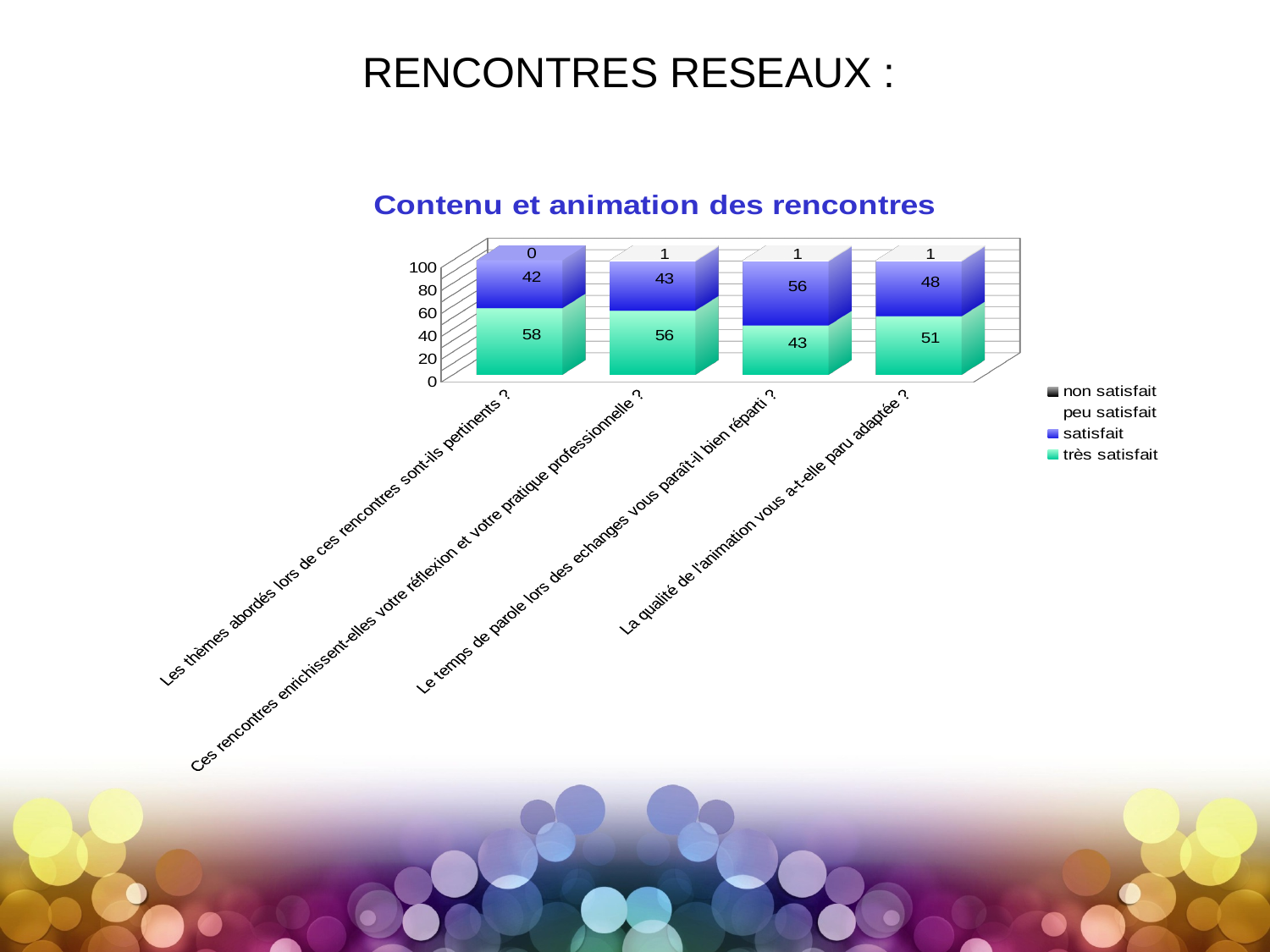
What is the 'satisfait' value for 'Le temps de parole lors des echanges vous paraît-il bien réparti ?'? 56 How many series does the chart legend list? 4 What kind of chart is shown on the slide? Stacked bar chart Which has the larger 'satisfait' value: 'Le temps de parole lors des echanges vous paraît-il bien réparti ?' or 'La qualité de l'animation vous a-t-elle paru adaptée ?'? Le temps de parole lors des echanges vous paraît-il bien réparti ? What is the 'très satisfait' value for 'La qualité de l'animation vous a-t-elle paru adaptée ?'? 51 What is the 'très satisfait' value for 'Les thèmes abordés lors de ces rencontres sont-ils pertinents ?'? 58 What is the 'satisfait' value for 'Ces rencontres enrichissent-elles votre réflexion et votre pratique professionnelle ?'? 43 How many questions (categories) are shown on the x axis of the chart? 4 For 'Les thèmes abordés lors de ces rencontres sont-ils pertinents ?', how much larger is the 'très satisfait' value than the 'satisfait' value? 16 Which question has the lowest 'très satisfait' value? Le temps de parole lors des echanges vous paraît-il bien réparti ? What is the difference between the 'satisfait' values for 'La qualité de l'animation vous a-t-elle paru adaptée ?' and 'Les thèmes abordés lors de ces rencontres sont-ils pertinents ?'? 6 Which question has the highest 'très satisfait' value? Les thèmes abordés lors de ces rencontres sont-ils pertinents ?